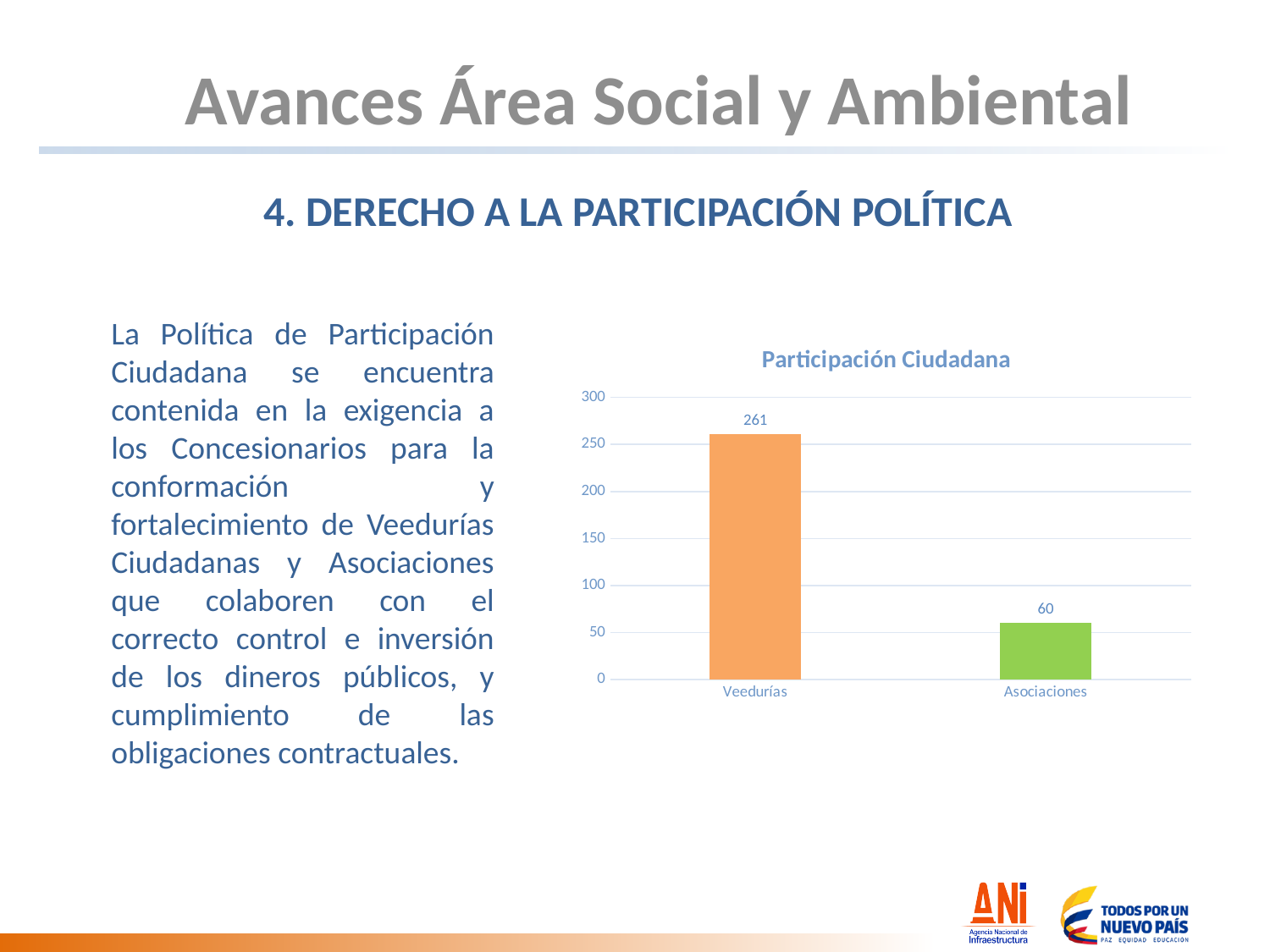
How many categories are shown in the chart? 2 Which is larger, the value for Veedurías or the value for Asociaciones? Veedurías Is the value for Veedurías greater or less than 250? greater What kind of chart is shown on the slide? bar chart What is the title of the chart? Participación Ciudadana What is the value for Asociaciones? 60 What is the difference between the values for Veedurías and Asociaciones? 201 What colour is the bar for Asociaciones? green Which category has the lowest value? Asociaciones Is the value for Asociaciones greater or less than 100? less What is the value for Veedurías? 261 Which category has the highest value? Veedurías